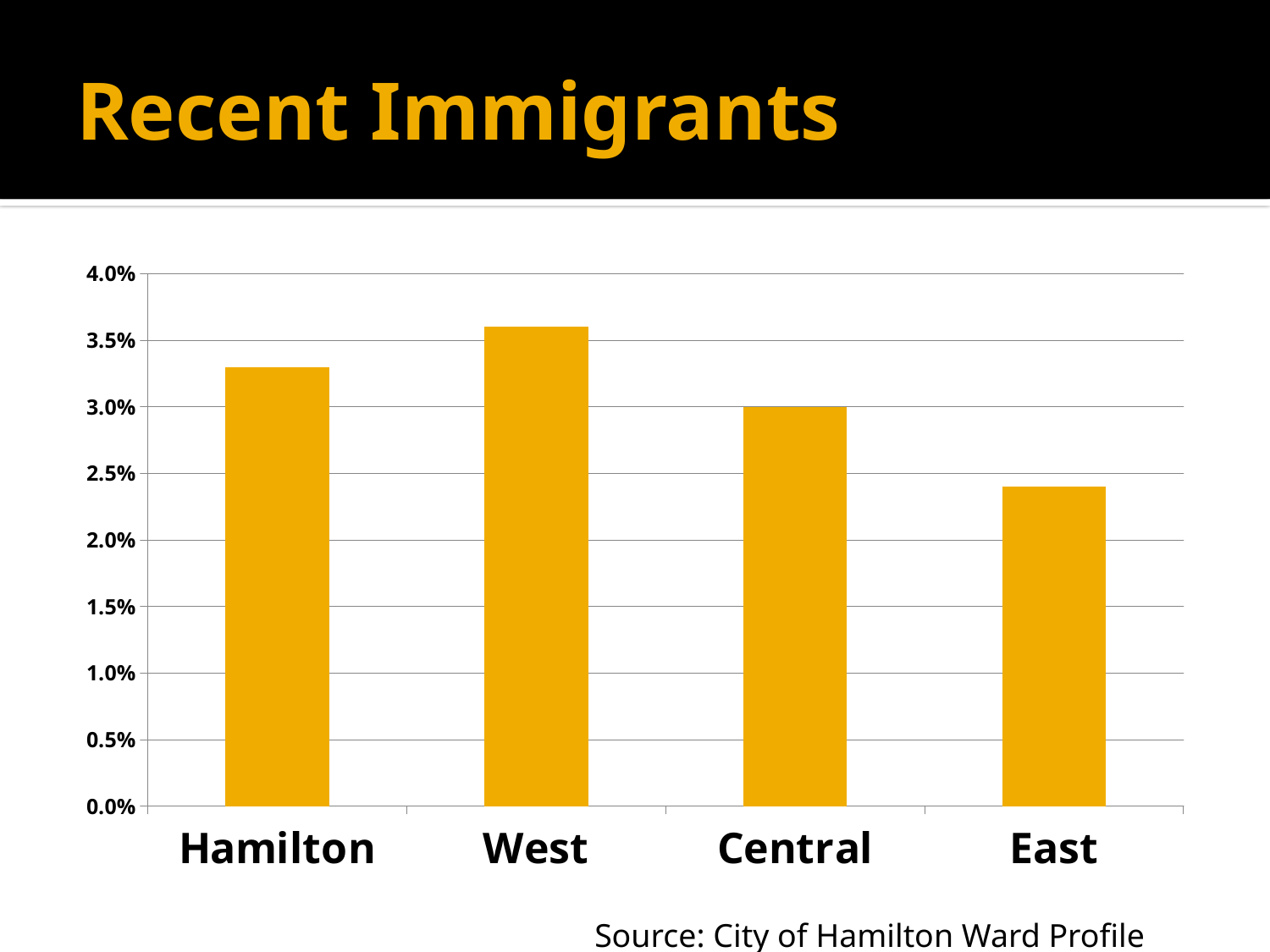
Is the value for West greater or less than 3.5%? greater Is the value for East greater or less than 2.5%? less Which is larger, the value for Central or the value for East? Central Is the value for Hamilton greater or less than 3.5%? less What is the title of the slide containing the chart? Recent Immigrants Which category has the highest value in the chart? West How many categories are shown on the x axis of the chart? 4 Which is larger, the value for Hamilton or the value for Central? Hamilton Which category has the lowest value in the chart? East What type of chart is shown on the slide? bar chart